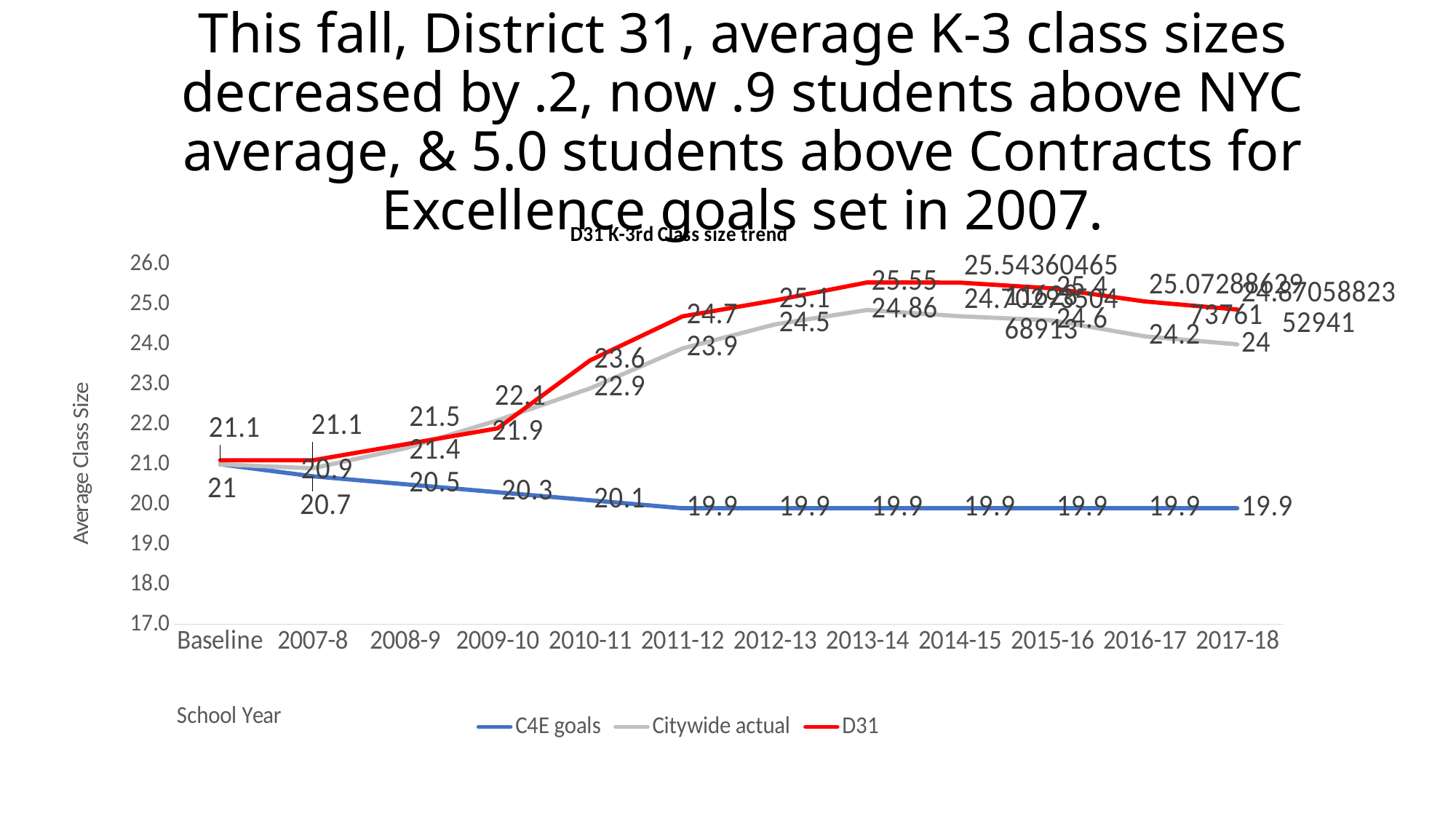
In 2010-11, which is larger: the D31 value or the Citywide actual value? D31 What is the D31 value for 2013-14? 25.55 What is the difference between the D31 value and the C4E goals value in 2012-13? 5.2 What is the difference between the D31 value and the Citywide actual value in 2011-12? 0.8 What is the Citywide actual value for 2017-18? 24 What is the Citywide actual value for 2011-12? 23.9 What is the C4E goals value for 2009-10? 20.3 What type of chart is shown on the slide? line chart What is the title of the chart? D31 K-3rd Class size trend Is the Citywide actual value for 2008-9 greater or less than 22.0? less How many series does the legend list? 3 How many school-year categories are shown on the x axis? 12